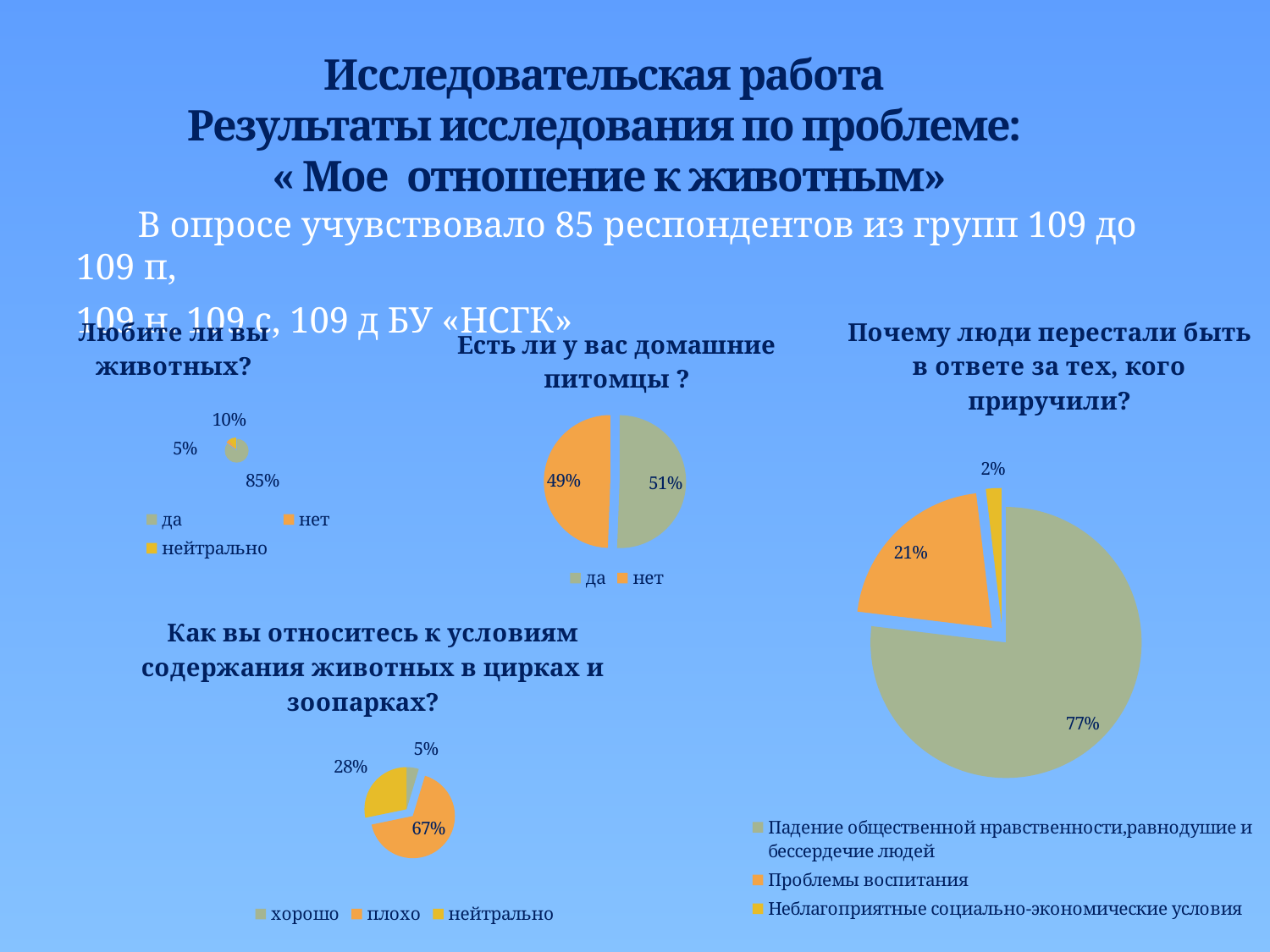
In the chart "Как вы относитесь к условиям содержания животных в цирках и зоопарках?", what percentage answered "нейтрально"? 28% In the chart "Почему люди перестали быть в ответе за тех, кого приручили?", what percentage is attributed to "Неблагоприятные социально-экономические условия"? 2% In the chart "Почему люди перестали быть в ответе за тех, кого приручили?", what percentage is attributed to "Проблемы воспитания"? 21% In the chart "Есть ли у вас домашние питомцы?", what percentage answered "нет"? 49% In the chart "Как вы относитесь к условиям содержания животных в цирках и зоопарках?", which answer has the smallest share? хорошо In the chart "Как вы относитесь к условиям содержания животных в цирках и зоопарках?", what percentage answered "плохо"? 67% In the chart "Любите ли вы животных?", what percentage answered "да"? 85% What type of chart is used for "Есть ли у вас домашние питомцы?"? Pie chart In the chart "Почему люди перестали быть в ответе за тех, кого приручили?", which reason has the largest share? Падение общественной нравственности, равнодушие и бессердечие людей In the chart "Есть ли у вас домашние питомцы?", what is the difference between the "да" and "нет" shares? 2% In the chart "Любите ли вы животных?", which answer has the largest share? да In the chart "Есть ли у вас домашние питомцы?", what percentage answered "да"? 51%